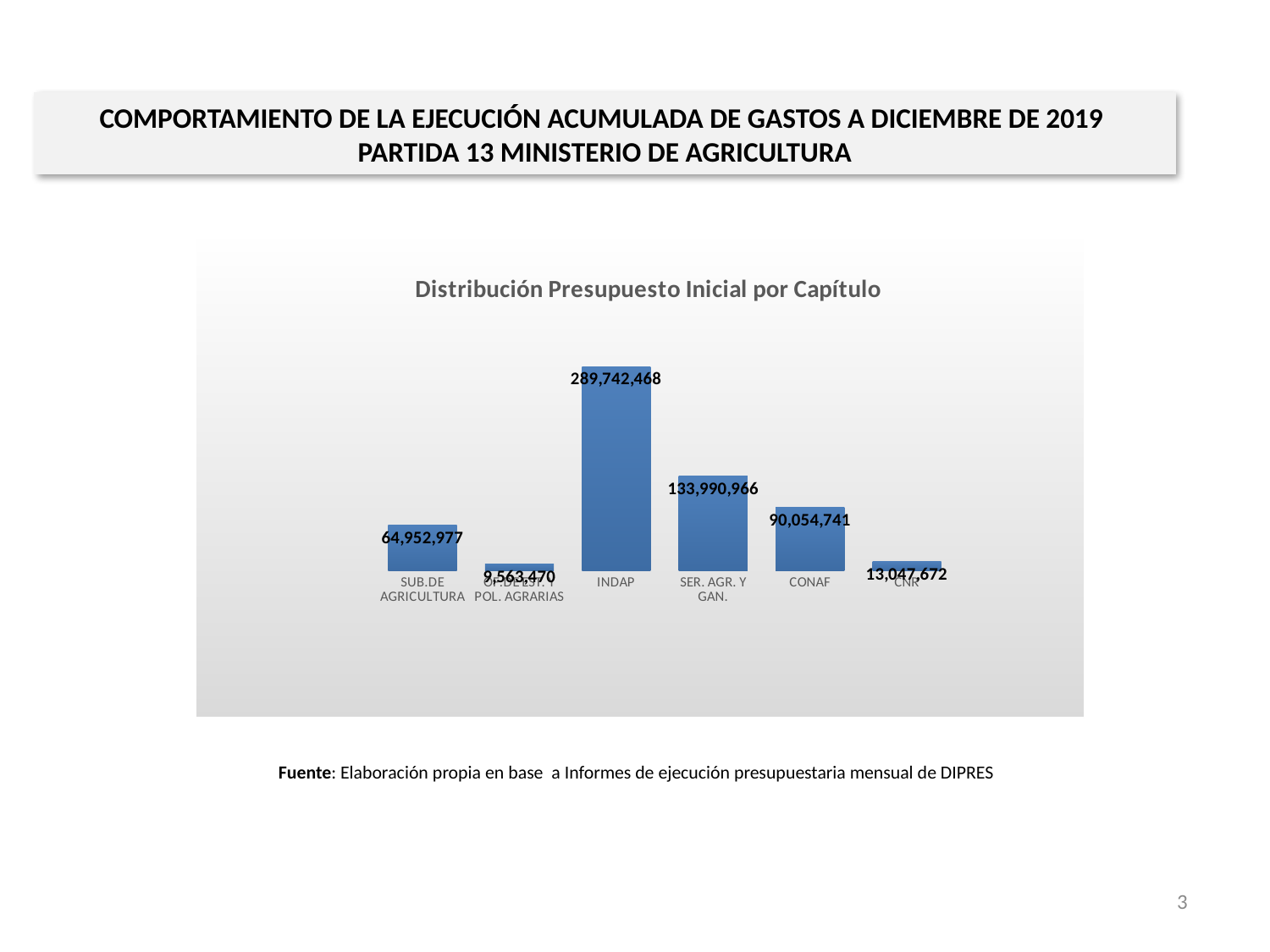
Which capítulo has the highest value in the chart? INDAP What is the value shown for INDAP? 289,742,468 What is the title of the chart? Distribución Presupuesto Inicial por Capítulo What is the difference between the values for INDAP and SER. AGR. Y GAN.? 155,751,502 What is the value shown for CONAF? 90,054,741 What is the value shown for CNR? 13,047,672 How many categories (capítulos) are plotted in the chart? 6 Which is larger, the value for SER. AGR. Y GAN. or the value for CONAF? SER. AGR. Y GAN. What is the value shown for SUB.DE AGRICULTURA? 64,952,977 What is the value shown for SER. AGR. Y GAN.? 133,990,966 What type of chart is shown on the slide? Bar chart What is the difference between the values for CONAF and SUB.DE AGRICULTURA? 25,101,764